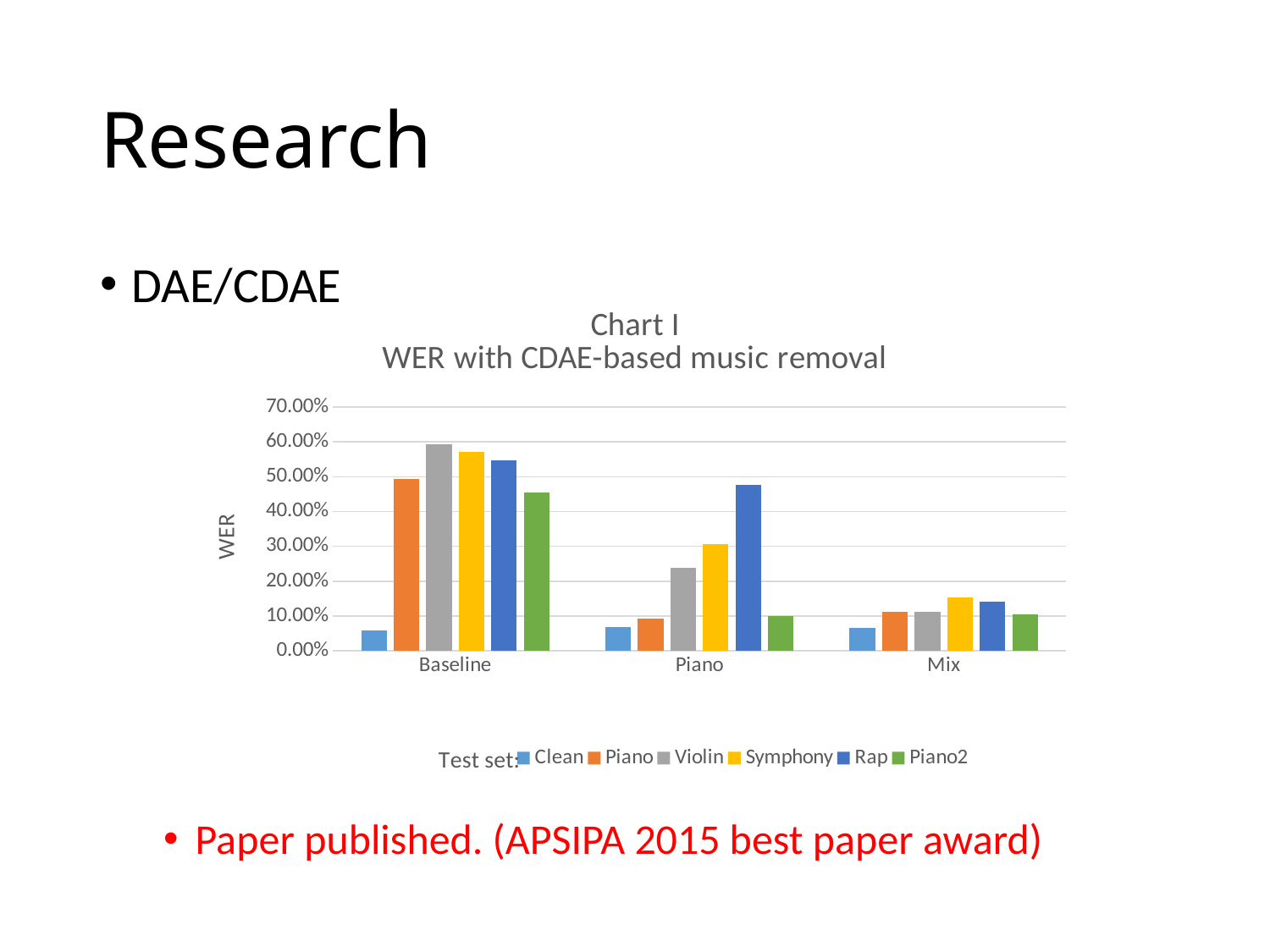
What kind of chart is shown on the slide? bar chart Is the value for Violin in the Baseline category greater or less than 50.00%? greater Is the value for Symphony in the Mix category greater or less than 20.00%? less Is the value for Piano2 in the Baseline category greater or less than 40.00%? greater Which test set has the highest WER in the Piano category? Rap How many series does the legend list? 6 Which is larger: the Rap value in the Baseline category or the Rap value in the Mix category? Baseline How many categories are shown on the x axis? 3 What is the label on the y axis of the chart? WER In the Piano category, which is larger: the Symphony value or the Violin value? Symphony Which test set has the lowest WER in the Baseline category? Clean